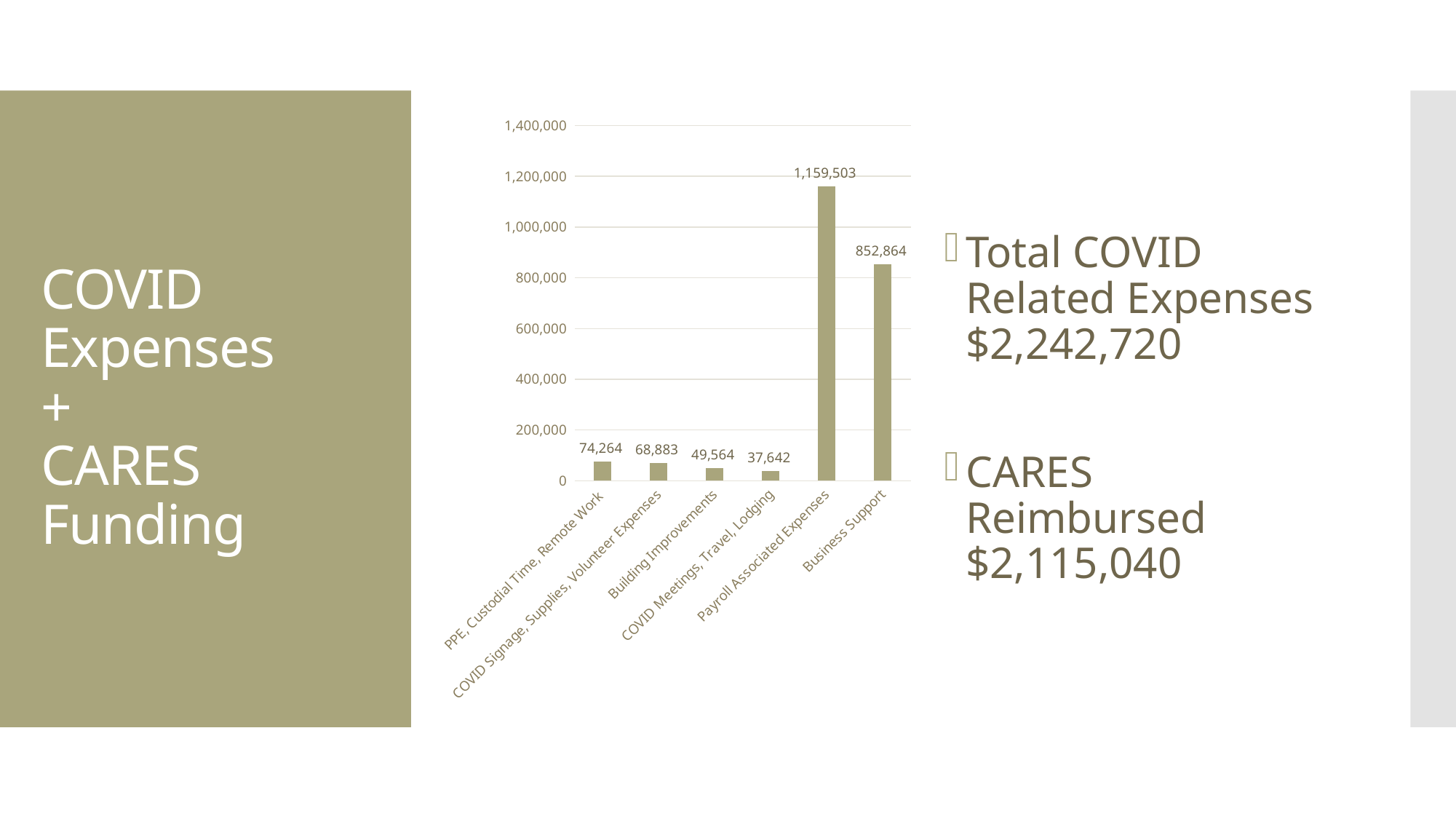
How many categories are shown in the chart? 6 What is the value for Building Improvements? 49,564 Which category has the lowest value? COVID Meetings, Travel, Lodging What is the value for COVID Meetings, Travel, Lodging? 37,642 Which category has the highest value? Payroll Associated Expenses What is the difference between Payroll Associated Expenses and Business Support? 306,639 What kind of chart is shown on the slide? Bar chart What is the difference between Building Improvements and COVID Meetings, Travel, Lodging? 11,922 What is the value for Payroll Associated Expenses? 1,159,503 Which is larger, PPE, Custodial Time, Remote Work or COVID Signage, Supplies, Volunteer Expenses? PPE, Custodial Time, Remote Work What is the value for PPE, Custodial Time, Remote Work? 74,264 What is the value for Business Support? 852,864